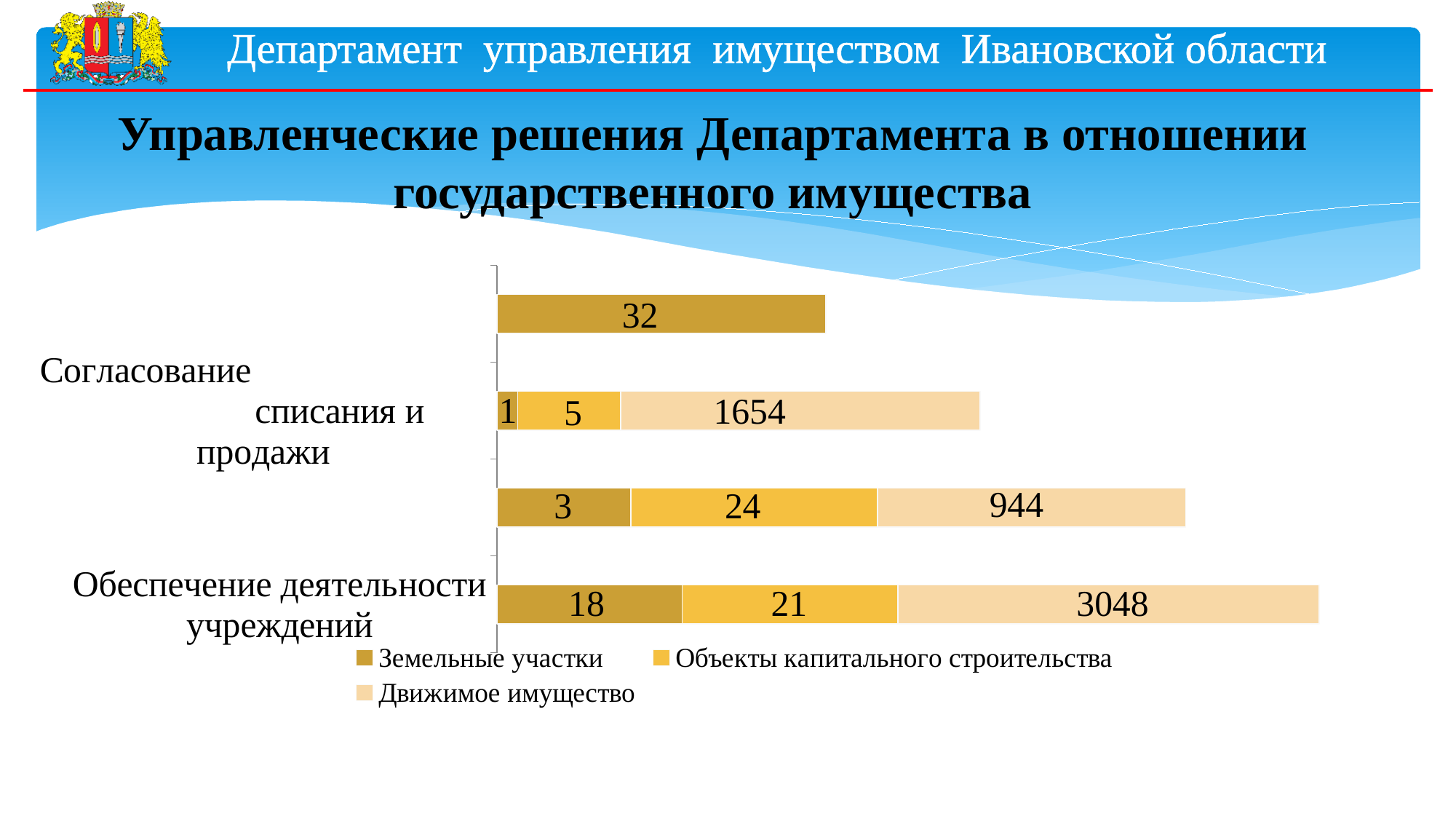
What is the value of Движимое имущество for Согласование списания и продажи? 1654 How many bars are plotted in the chart? 4 What is the total of the stacked bar for Обеспечение деятельности учреждений? 3087 What value is labelled on the topmost bar of the chart? 32 How many series does the legend list? 3 Which has the larger value for Объекты капитального строительства: Согласование списания и продажи or Обеспечение деятельности учреждений? Обеспечение деятельности учреждений What kind of chart is shown on the slide? bar chart What is the value of Объекты капитального строительства for Согласование списания и продажи? 5 What is the value of Движимое имущество for Обеспечение деятельности учреждений? 3048 What is the total of the stacked bar for Согласование списания и продажи? 1660 What is the value of Земельные участки for Обеспечение деятельности учреждений? 18 What is the difference in Движимое имущество between Обеспечение деятельности учреждений and Согласование списания и продажи? 1394